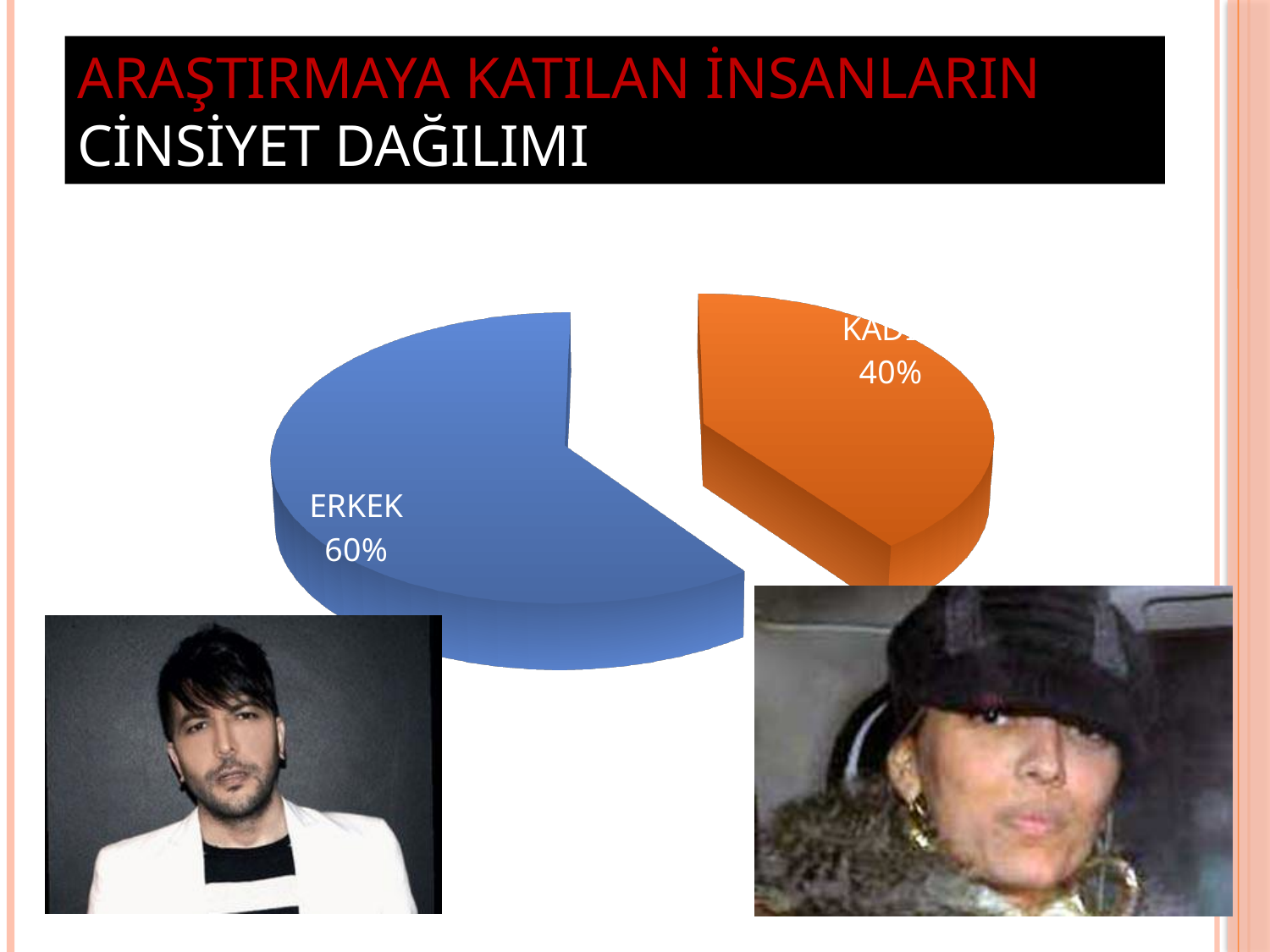
Which is larger: the ERKEK slice or the orange slice? ERKEK What is the difference in percentage points between the ERKEK slice and the orange slice? 20 What colour is the ERKEK slice? blue Is the ERKEK share greater or less than 50%? greater Which slice of the pie chart is the largest? ERKEK What percentage does the ERKEK slice show? 60% What kind of chart is shown on the slide? pie chart What percentage is printed on the orange slice of the pie chart? 40% What is the title of the slide containing the pie chart? ARAŞTIRMAYA KATILAN İNSANLARIN CİNSİYET DAĞILIMI How many slices does the pie chart have? 2